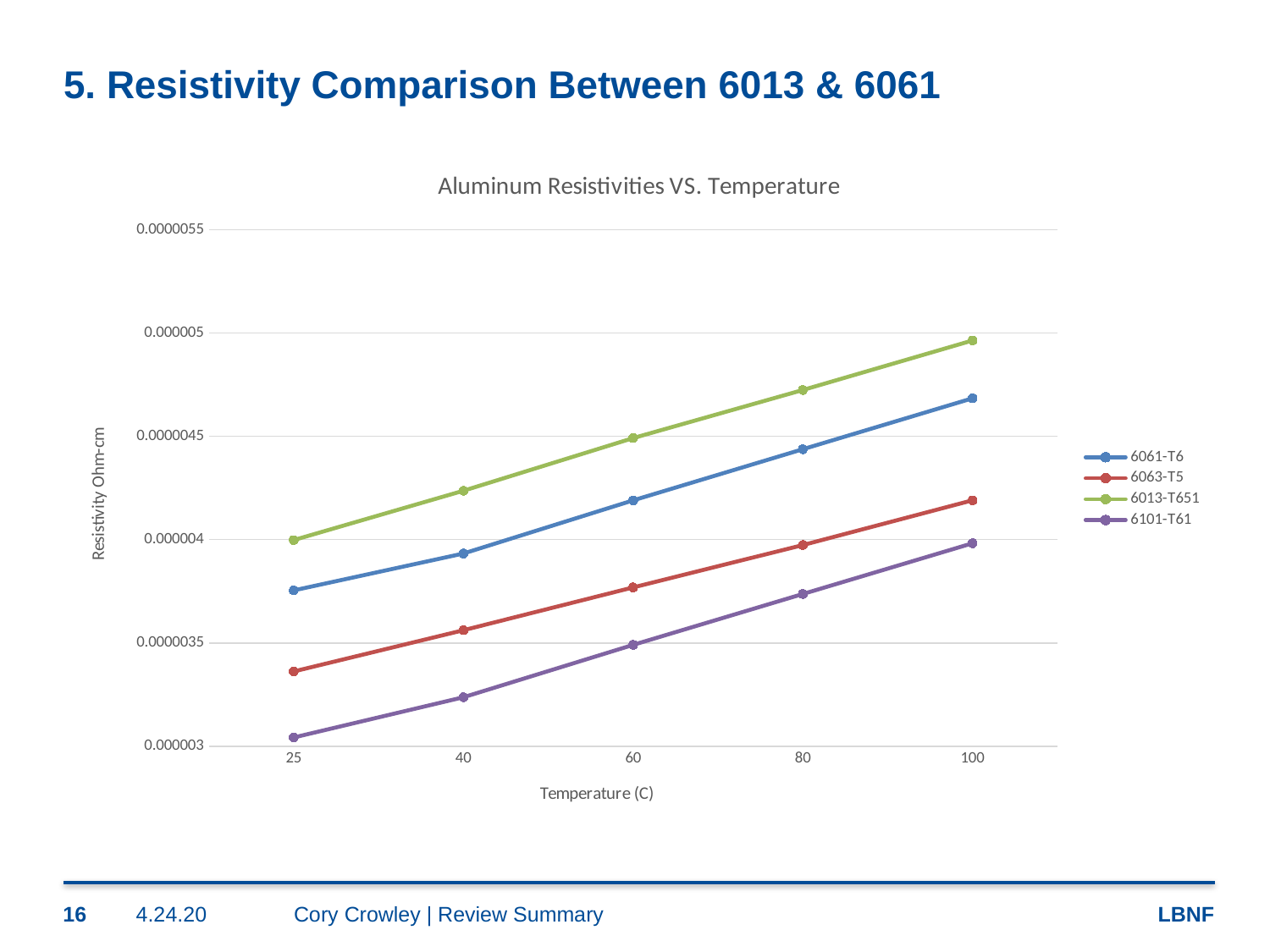
Is the resistivity of 6101-T61 at 25 C greater or less than 0.0000035? less Is the resistivity of 6013-T651 at 100 C greater or less than 0.0000045? greater What is the label of the y axis? Resistivity Ohm-cm What is the title of the chart? Aluminum Resistivities VS. Temperature Is the resistivity of 6061-T6 at 25 C greater or less than 0.000004? less What kind of chart is shown on the slide? line chart How many series does the legend list? 4 At 100 C, which series has the larger resistivity, 6061-T6 or 6063-T5? 6061-T6 Do the resistivity values rise or fall as temperature increases? rise How many temperature points are plotted along the x axis? 5 Which series has the lowest resistivity at 25 C? 6101-T61 Which series has the highest resistivity at 100 C? 6013-T651